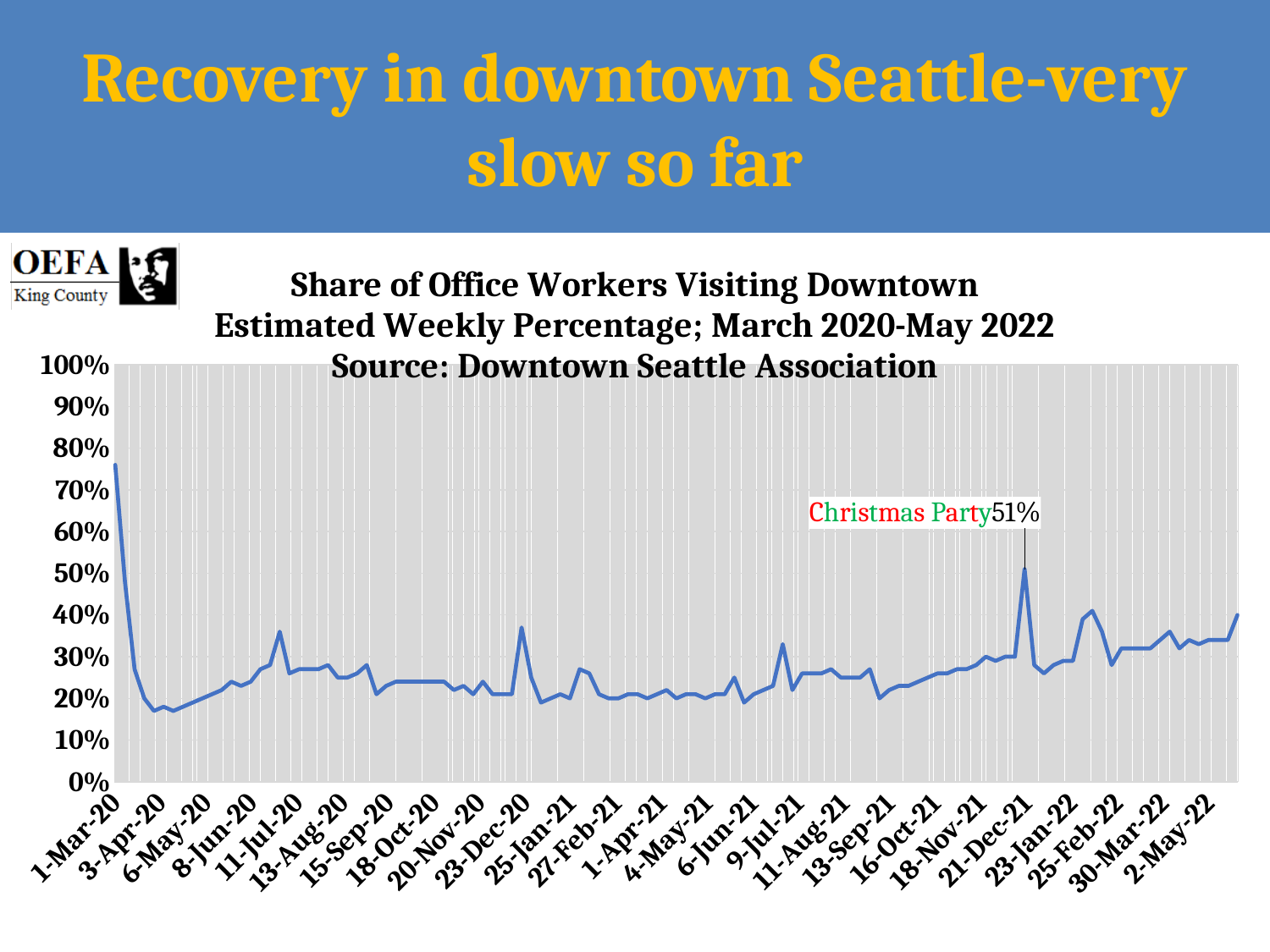
How many lines are plotted on the chart? 1 Does the line rise or fall between 1-Mar-20 and 3-Apr-20? fall At which x-axis date does the line reach its highest value? 1-Mar-20 What is the highest value shown on the y axis? 100% Is the value at 1-Mar-20 greater or less than 60%? greater What is the source of the data cited in the chart title? Downtown Seattle Association Which is larger: the value at 1-Mar-20 or the 'Christmas Party' peak value? 1-Mar-20 Is the value at 3-Apr-20 greater or less than 30%? less How many date labels are shown on the x axis? 25 What value is labelled at the 'Christmas Party' peak on the chart? 51% Is the value at the 'Christmas Party' peak greater or less than 40%? greater What kind of chart is shown on the slide? line chart